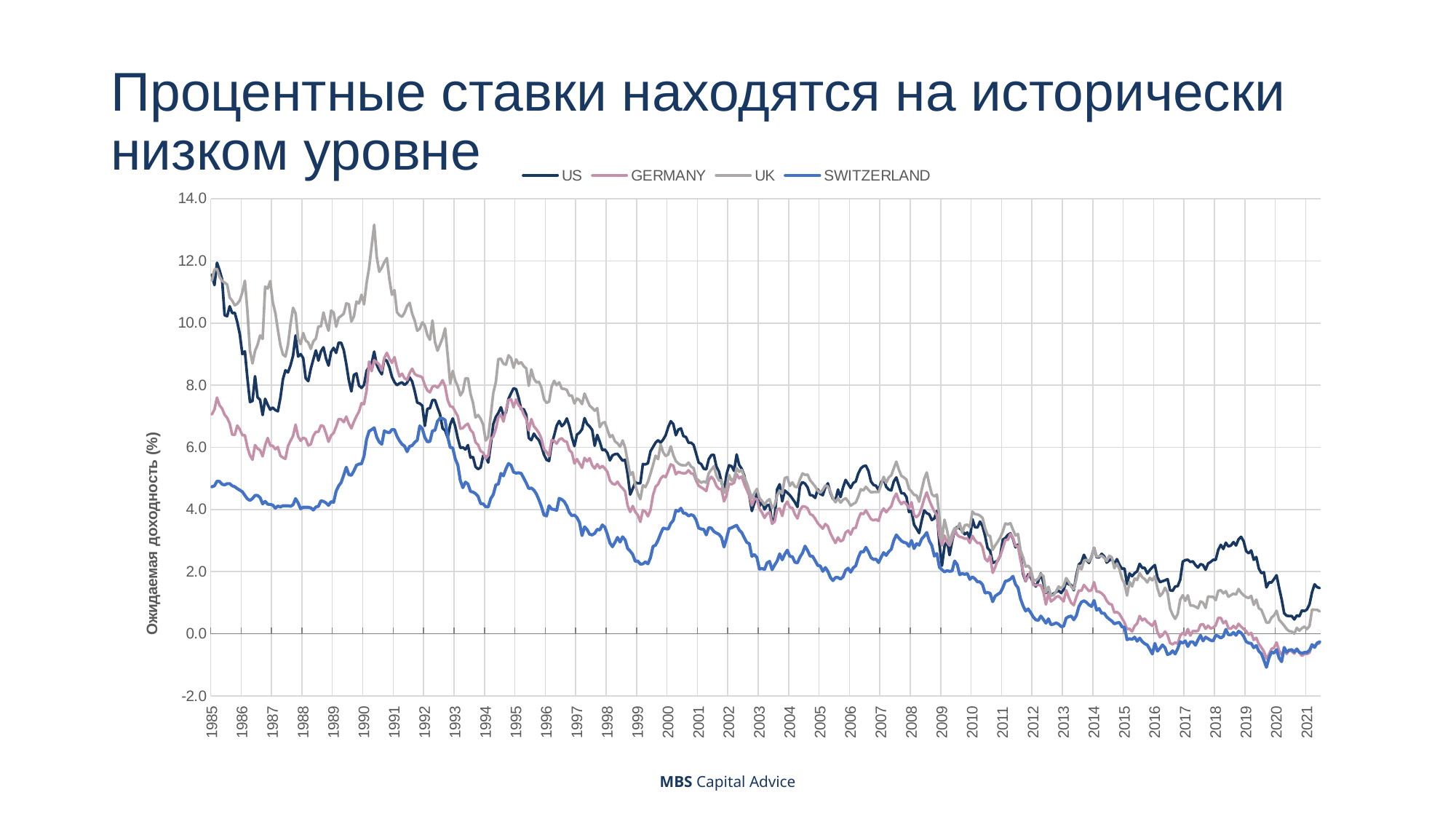
Is the value for SWITZERLAND in 2016 greater or less than 0.0? less In 1985, which is larger: the value for UK or the value for SWITZERLAND? UK Overall, do the values rise or fall from 1985 to 2021? fall Is the peak value of the UK series around 1990 greater or less than 12.0? greater Is the value for SWITZERLAND in 1985 greater or less than 6.0? less What is the label of the vertical axis? Ожидаемая доходность (%) Which series are listed in the legend? US, GERMANY, UK, SWITZERLAND Which series reaches the highest value anywhere on the chart? UK Which series has the lowest value at the start of the chart in 1985? SWITZERLAND How many series does the legend list? 4 What kind of chart is shown on the slide? line chart How many year labels are shown on the x axis? 37